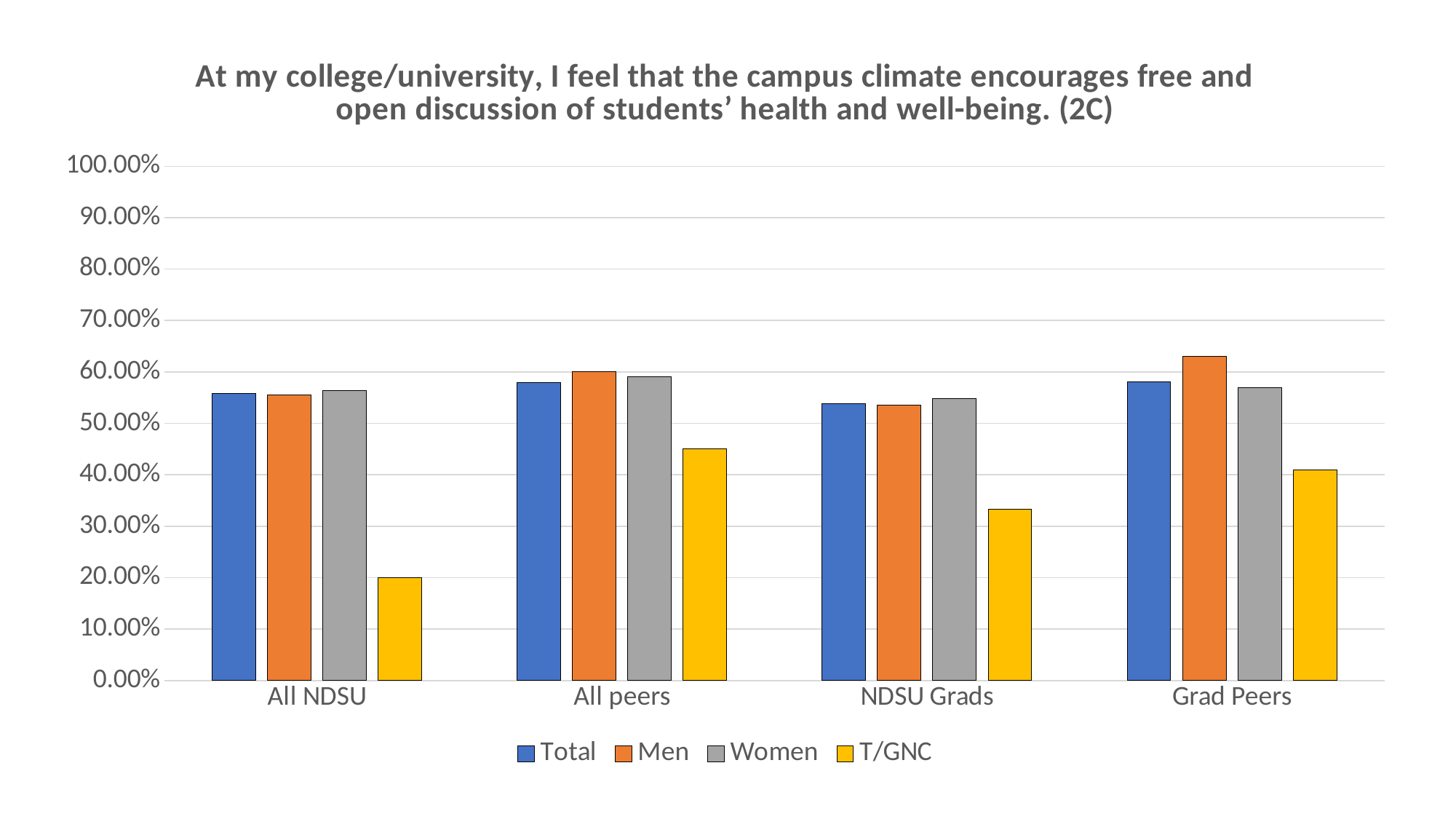
Is the value for T/GNC in the NDSU Grads category greater or less than 40.00%? less In which category is the Men value highest? Grad Peers How many categories are shown on the x axis? 4 Is the value for T/GNC in the All peers category greater or less than 40.00%? greater Is the value for Women in the All NDSU category greater or less than 50.00%? greater Which is larger: the T/GNC value for All peers or the T/GNC value for NDSU Grads? All peers In which category is the T/GNC value lowest? All NDSU What kind of chart is shown on the slide? bar chart How many series does the legend list? 4 Which series has the lowest value in the Grad Peers category? T/GNC